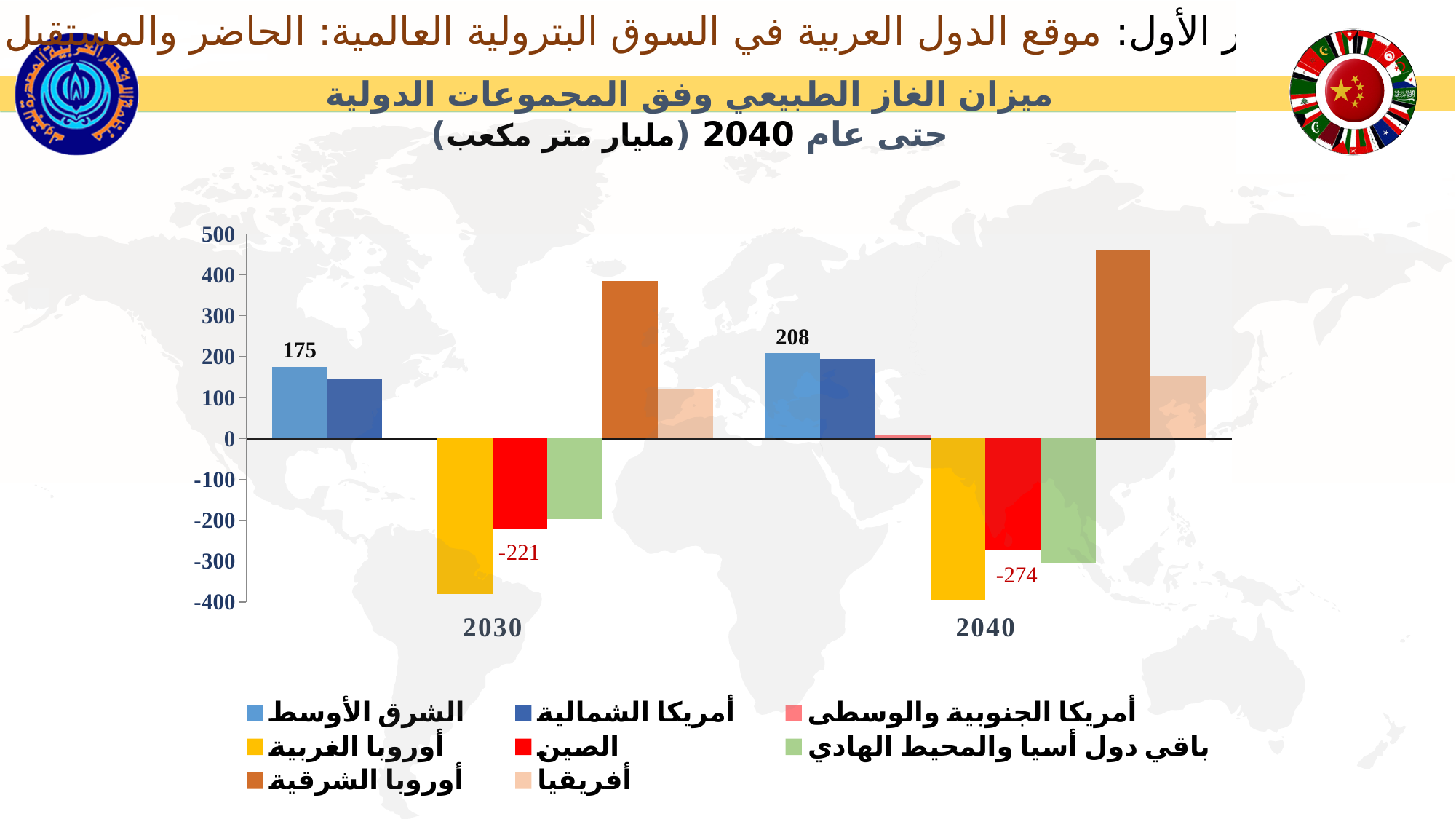
Which series has the highest value in 2040? أوروبا الشرقية What is the value for الشرق الأوسط in 2030? 175 What is the value for الصين in 2040? -274 What is the difference between the value for الصين in 2030 and in 2040? 53 What kind of chart is shown on the slide? bar chart What is the value for الشرق الأوسط in 2040? 208 Is the value for أوروبا الشرقية in 2030 greater or less than 300? greater Which series has the lowest value in 2030? أوروبا الغربية Is the value for أوروبا الغربية in 2040 greater or less than -300? less How many series does the legend list? 8 By how much does the value for الشرق الأوسط increase from 2030 to 2040? 33 What is the value for الصين in 2030? -221